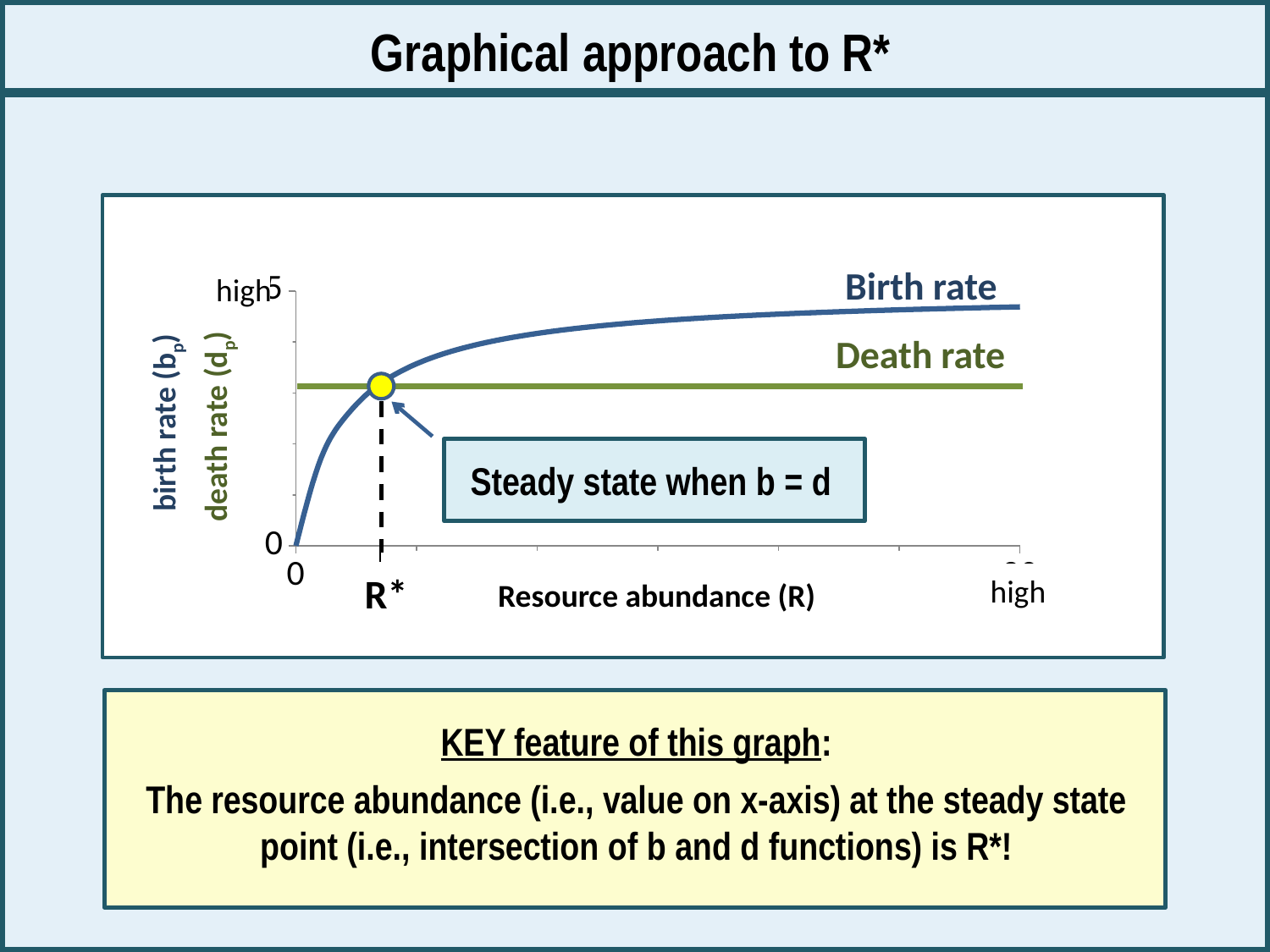
What is the label on the x-axis of the chart? Resource abundance (R) Does the Birth rate curve rise or fall as resource abundance (R) increases? Rises At high resource abundance (right side of the chart), which is larger: the Birth rate or the Death rate? Birth rate What is the maximum value shown on the y-axis of the chart? 5 What is the title of the slide containing the chart? Graphical approach to R* How many series are plotted on the chart? 2 Does the Death rate line rise, fall, or stay flat as resource abundance (R) increases? Stays flat At resource abundance just above 0 (left side of the chart), which is larger: the Birth rate or the Death rate? Death rate What are the names of the two series plotted on the chart? Birth rate and Death rate What kind of chart is shown on the slide? Line chart Is the Death rate value greater or less than 5? less What is the x-axis value labelled at the point where the Birth rate and Death rate curves intersect? R*